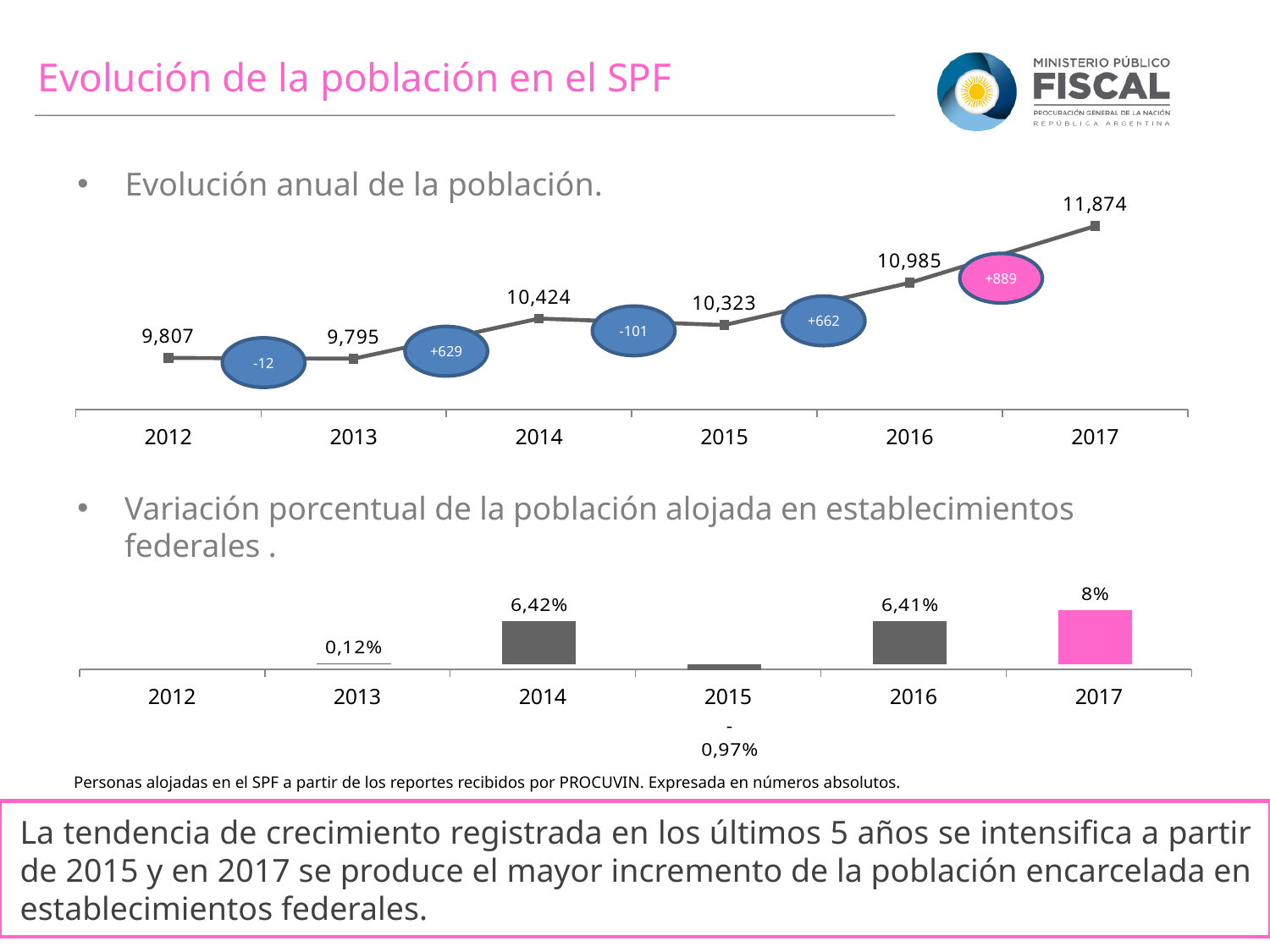
In the 'Evolución anual de la población' chart, how many years are plotted? 6 In the 'Evolución anual de la población' chart, what is the value for 2012? 9,807 In the 'Variación porcentual' chart, which year has the highest value? 2017 In the 'Evolución anual de la población' chart, what is the value for 2017? 11,874 In the 'Variación porcentual' chart, what is the value for 2014? 6,42% In the 'Evolución anual de la población' chart, which is larger, the value for 2014 or the value for 2015? 2014 In the 'Evolución anual de la población' chart, what is the difference between the 2017 value and the 2016 value? 889 In the 'Evolución anual de la población' chart, which year has the highest value? 2017 In the 'Variación porcentual' chart, what is the value for 2015? -0,97% What type of chart is the 'Evolución anual de la población' chart? Line chart What type of chart is the 'Variación porcentual' chart? Bar chart In the 'Evolución anual de la población' chart, which year has the lowest value? 2013